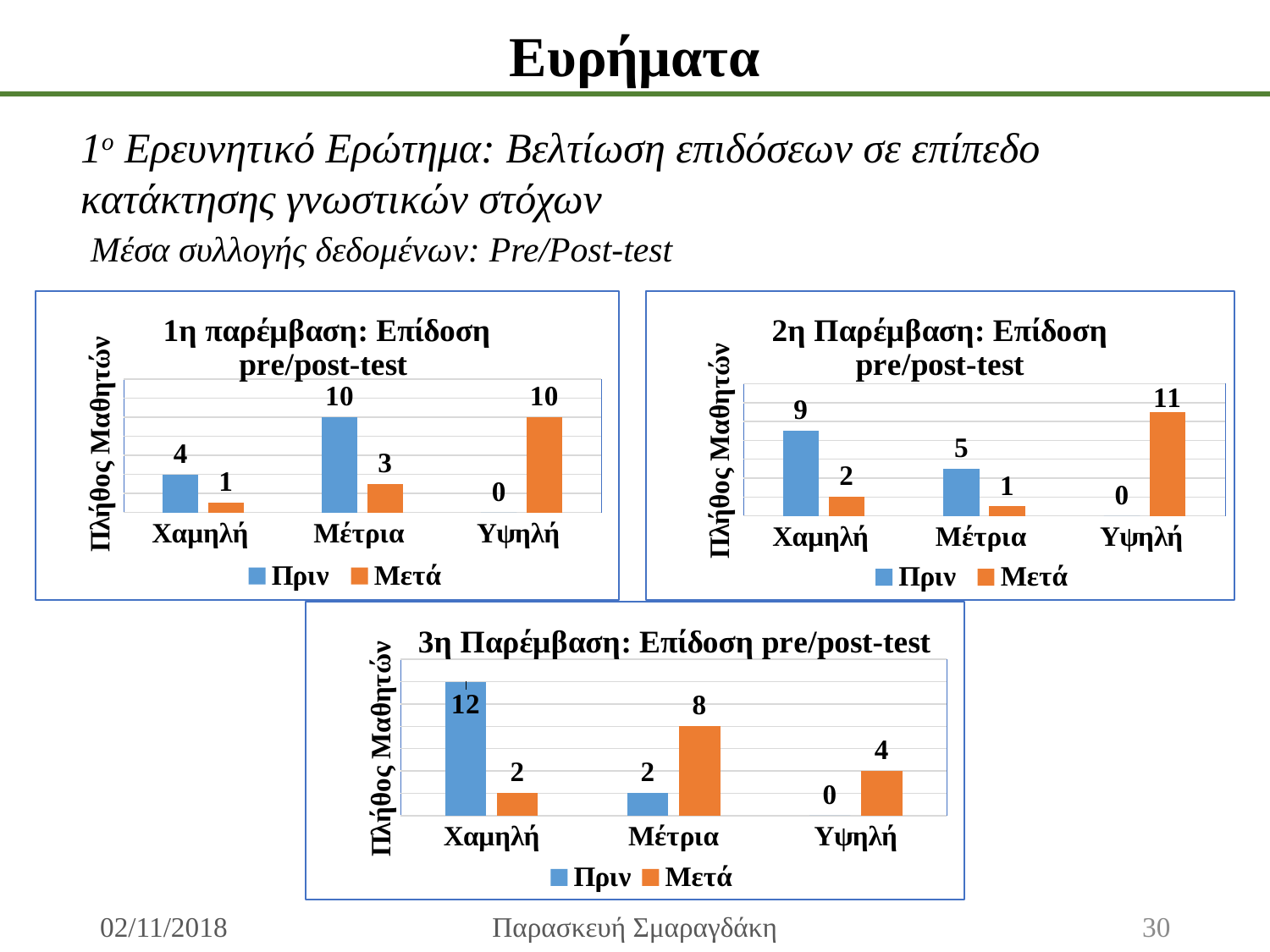
In the chart titled "1η παρέμβαση: Επίδοση pre/post-test", what is the difference between Πριν and Μετά for Χαμηλή? 3 In the chart titled "3η Παρέμβαση: Επίδοση pre/post-test", what is the value of Πριν for Χαμηλή? 12 In the chart titled "1η παρέμβαση: Επίδοση pre/post-test", what is the value of Πριν for Μέτρια? 10 In the chart titled "2η Παρέμβαση: Επίδοση pre/post-test", which is larger for Μέτρια, Πριν or Μετά? Πριν How many categories are shown on the x axis of the chart titled "3η Παρέμβαση: Επίδοση pre/post-test"? 3 How many series does the legend list in the chart titled "1η παρέμβαση: Επίδοση pre/post-test"? 2 In the chart titled "2η Παρέμβαση: Επίδοση pre/post-test", what is the value of Πριν for Χαμηλή? 9 In the chart titled "3η Παρέμβαση: Επίδοση pre/post-test", what is the difference between Μετά and Πριν for Μέτρια? 6 In the chart titled "3η Παρέμβαση: Επίδοση pre/post-test", which category has the lowest Πριν value? Υψηλή In the chart titled "2η Παρέμβαση: Επίδοση pre/post-test", which category has the highest Μετά value? Υψηλή What type of chart is the chart titled "2η Παρέμβαση: Επίδοση pre/post-test"? Bar chart In the chart titled "1η παρέμβαση: Επίδοση pre/post-test", what is the value of Μετά for Υψηλή? 10